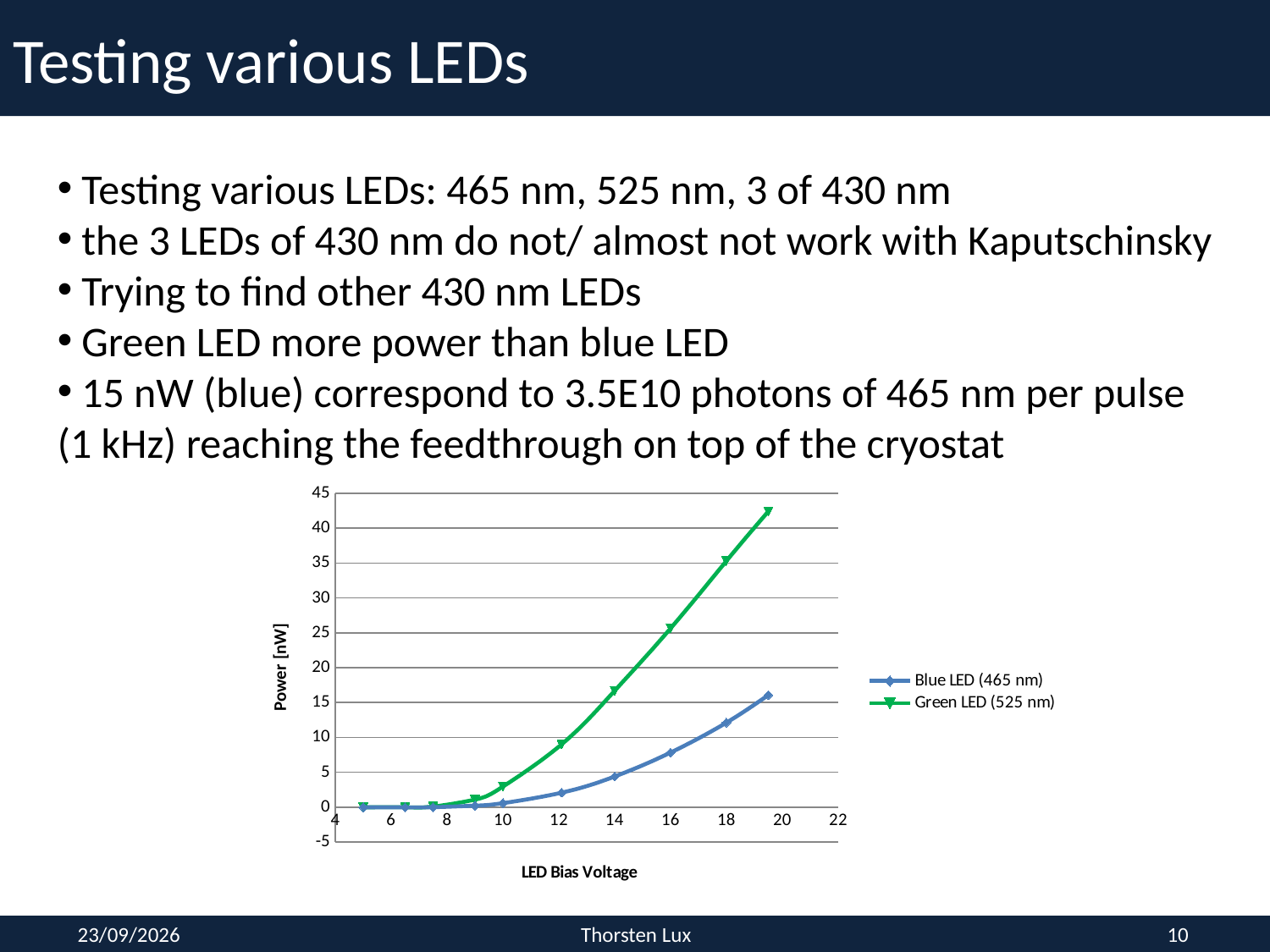
What is the label of the chart's y axis? Power [nW] Is the power of the Green LED (525 nm) at a bias voltage of 16 greater or less than 20? greater What are the two series named in the chart legend? Blue LED (465 nm) and Green LED (525 nm) Is the power of the Green LED (525 nm) at its highest plotted bias voltage greater or less than 40? greater How many series does the chart legend list? 2 Is the power of the Blue LED (465 nm) at a bias voltage of 16 greater or less than 10? less Do the power values for the Blue LED (465 nm) rise or fall as LED Bias Voltage increases? rise Which series reaches the higher power at the highest bias voltage plotted, Blue LED (465 nm) or Green LED (525 nm)? Green LED (525 nm) What kind of chart is shown on the slide? line chart Do the power values for the Green LED (525 nm) rise or fall as LED Bias Voltage increases? rise At a bias voltage of 14, which series has the higher power, Blue LED (465 nm) or Green LED (525 nm)? Green LED (525 nm)